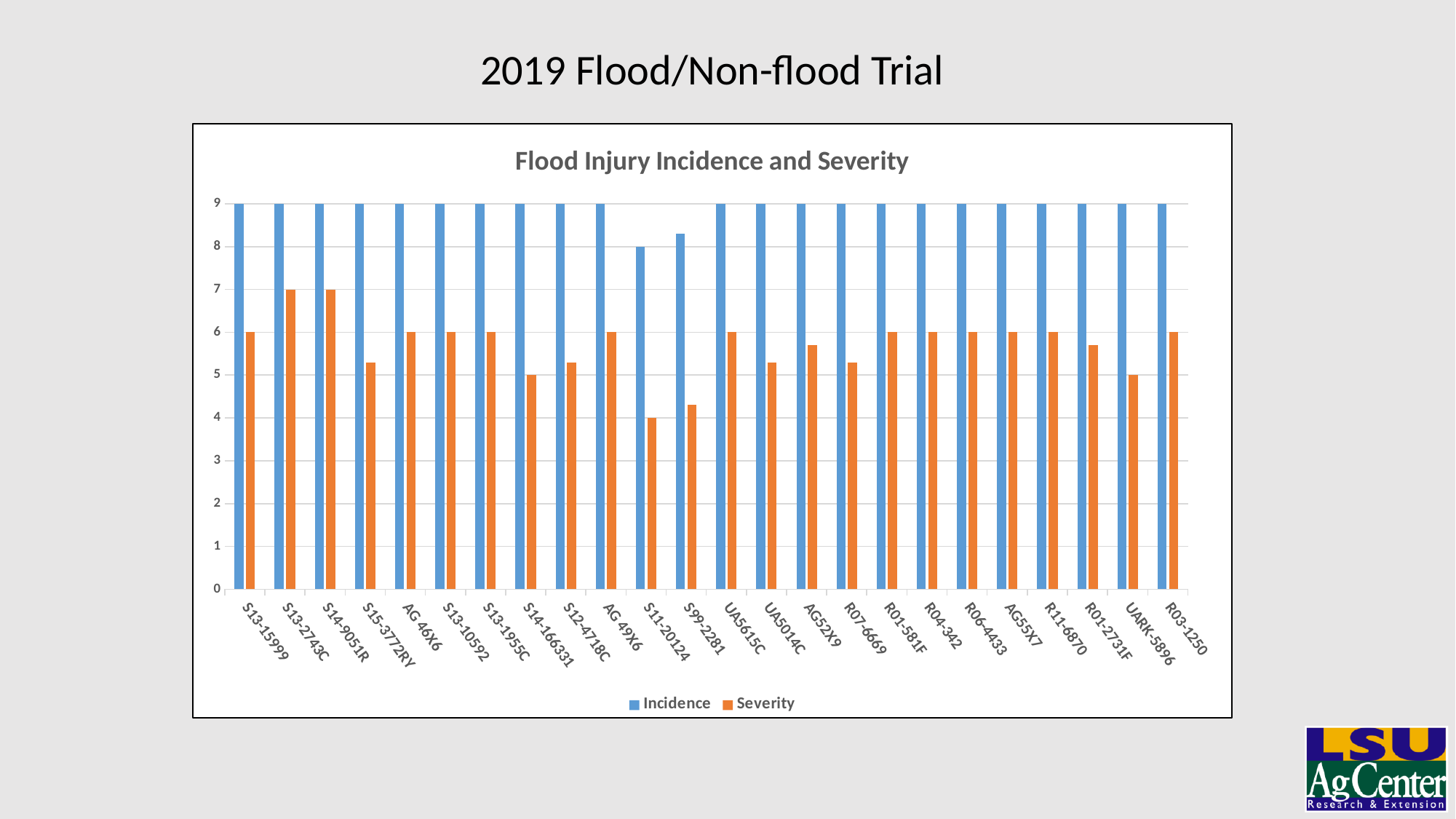
How many varieties (categories) are plotted along the x axis? 24 What kind of chart is shown on the slide? bar chart What is the title of the chart? Flood Injury Incidence and Severity Is the Severity value for S15-3772RY greater or less than 5? greater What is the difference between the Incidence and Severity values for S11-20124? 4 Is the Severity value for S99-2281 greater or less than 5? less What is the Severity value for S13-2743C? 7 Which has the higher Severity value, S13-2743C or S13-15999? S13-2743C What is the Severity value for S11-20124? 4 What is the Incidence value for S13-15999? 9 How many series does the legend list? 2 What is the Incidence value for S11-20124? 8